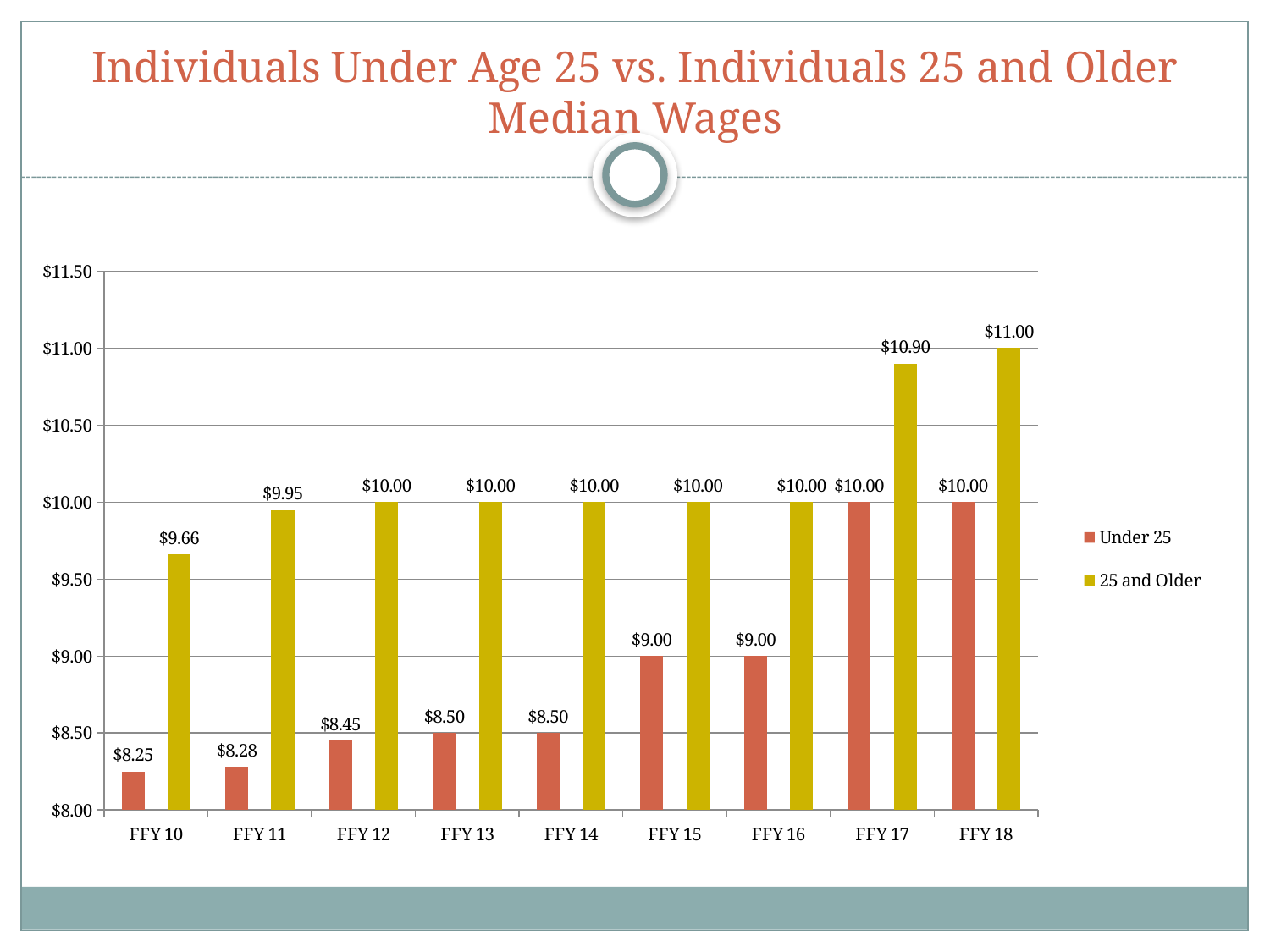
In which year is the median wage for 25 and Older highest? FFY 18 How many fiscal years are shown on the x axis? 9 Which is larger in FFY 11: the Under 25 median wage or the 25 and Older median wage? 25 and Older How many series does the legend list? 2 What is the median wage for 25 and Older in FFY 17? $10.90 In which year is the median wage for Under 25 lowest? FFY 10 What kind of chart is shown on the slide? Bar chart What is the median wage for Under 25 in FFY 15? $9.00 What is the difference between the 25 and Older and Under 25 median wages in FFY 12? $1.55 Does the Under 25 median wage rise or fall from FFY 10 to FFY 18? Rise What colour are the bars for the 25 and Older series? Yellow What is the median wage for Under 25 in FFY 10? $8.25